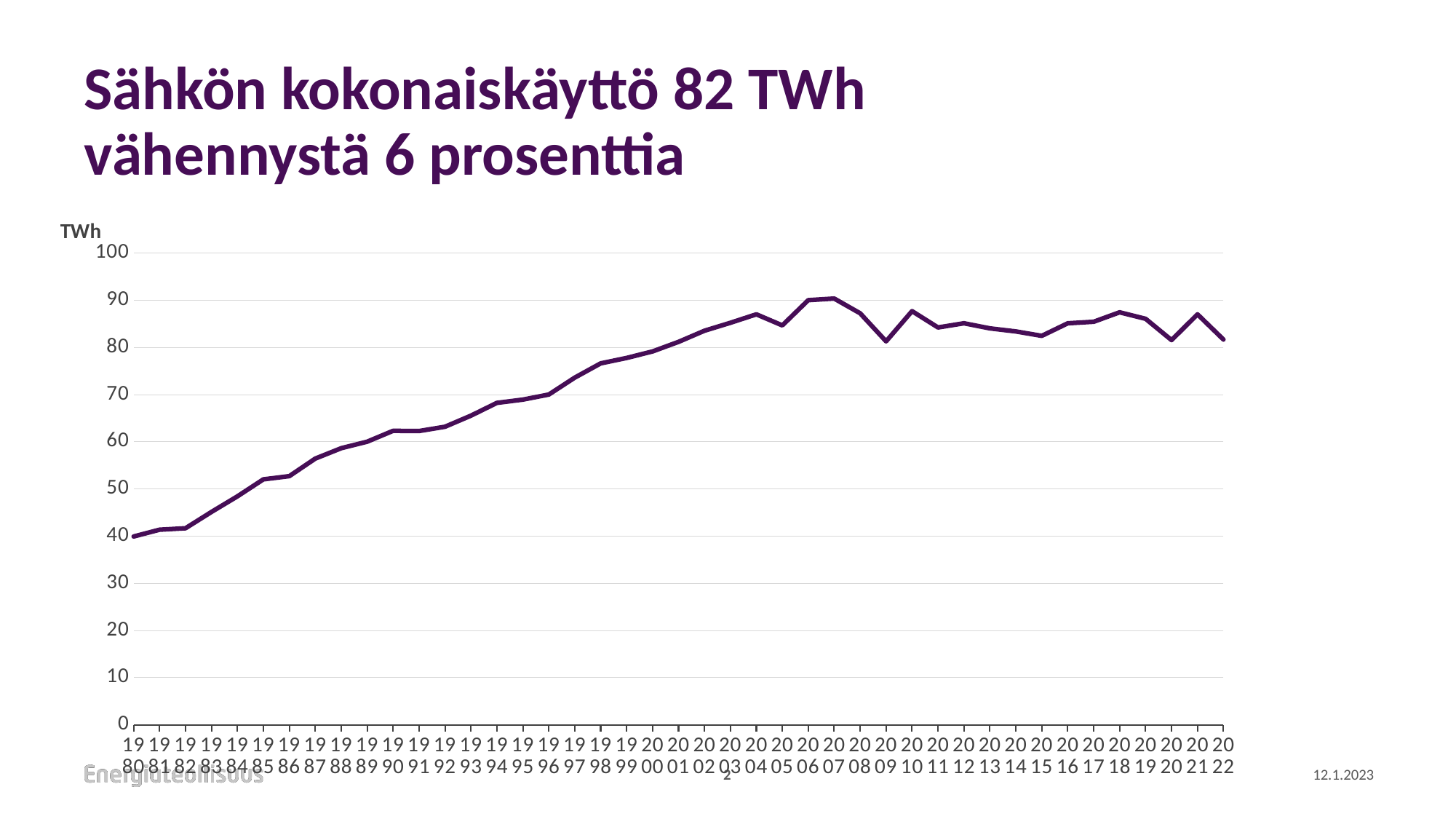
What is the title of the slide containing the chart? Sähkön kokonaiskäyttö 82 TWh vähennystä 6 prosenttia Is the value for 1985 greater or less than 50? greater Is the value for 1990 greater or less than 60? greater Is the value for 1998 greater or less than 70? greater What kind of chart is shown on the slide? line chart What unit is shown on the vertical axis of the chart? TWh Which year has the higher value, 2009 or 2010? 2010 Does electricity consumption generally rise or fall from 1980 to 2007? rise How many years are plotted on the x axis of the chart? 43 Which year has the higher value, 1990 or 2000? 2000 Which year has the lowest electricity consumption in the chart? 1980